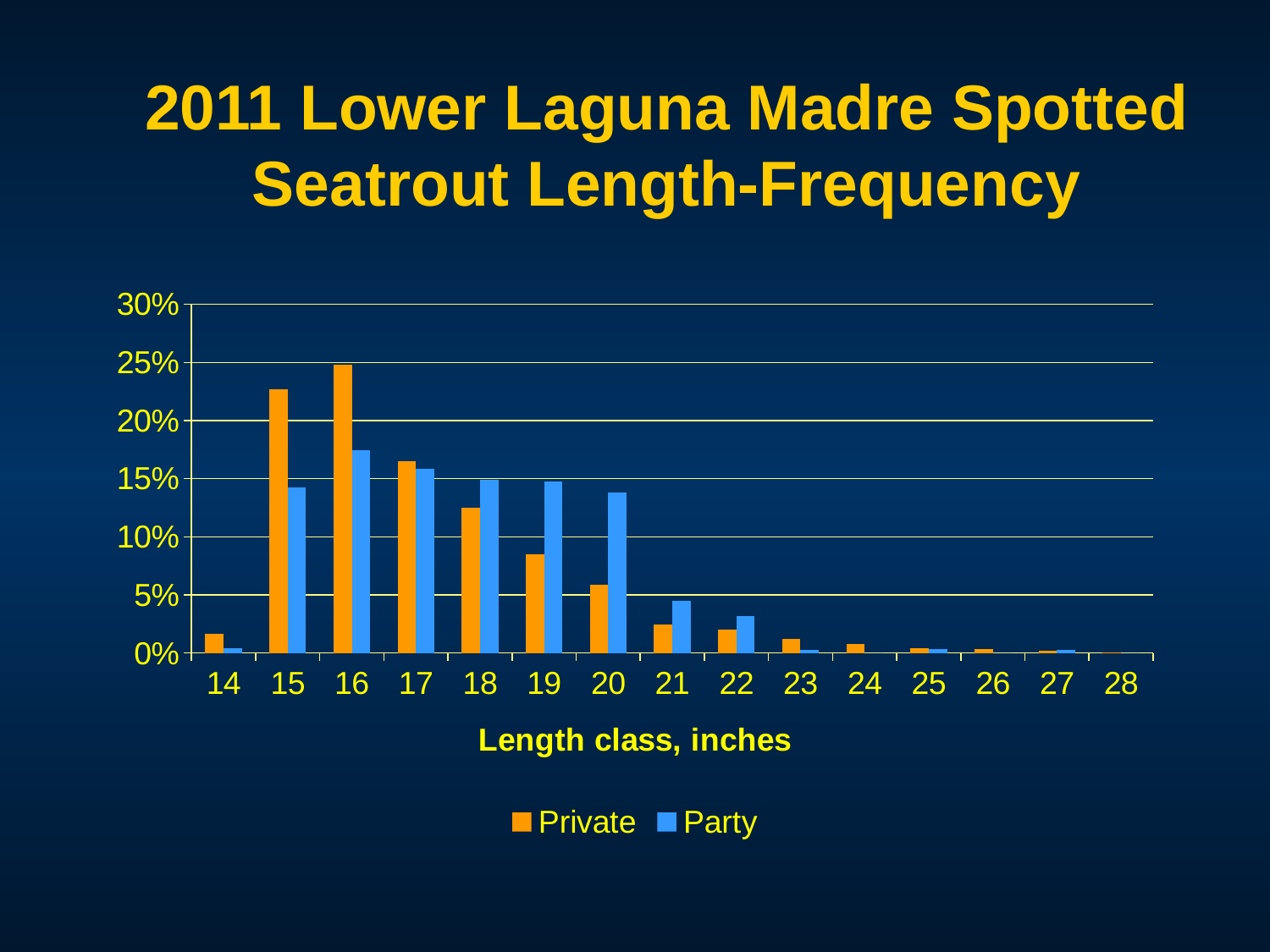
At length class 15, which series has the larger value, Private or Party? Private Is the Private value for length class 20 greater or less than 10%? less What kind of chart is shown on the slide? bar chart Is the Party value for length class 19 greater or less than 10%? greater Is the Party value for length class 16 greater or less than 15%? greater How many length classes are shown on the x axis? 15 Do the Private values rise or fall from length class 16 to length class 28? fall Which length class has the highest Party value? 16 Which length class has the highest Private value? 16 How many series does the legend list? 2 At length class 19, which series has the larger value, Private or Party? Party